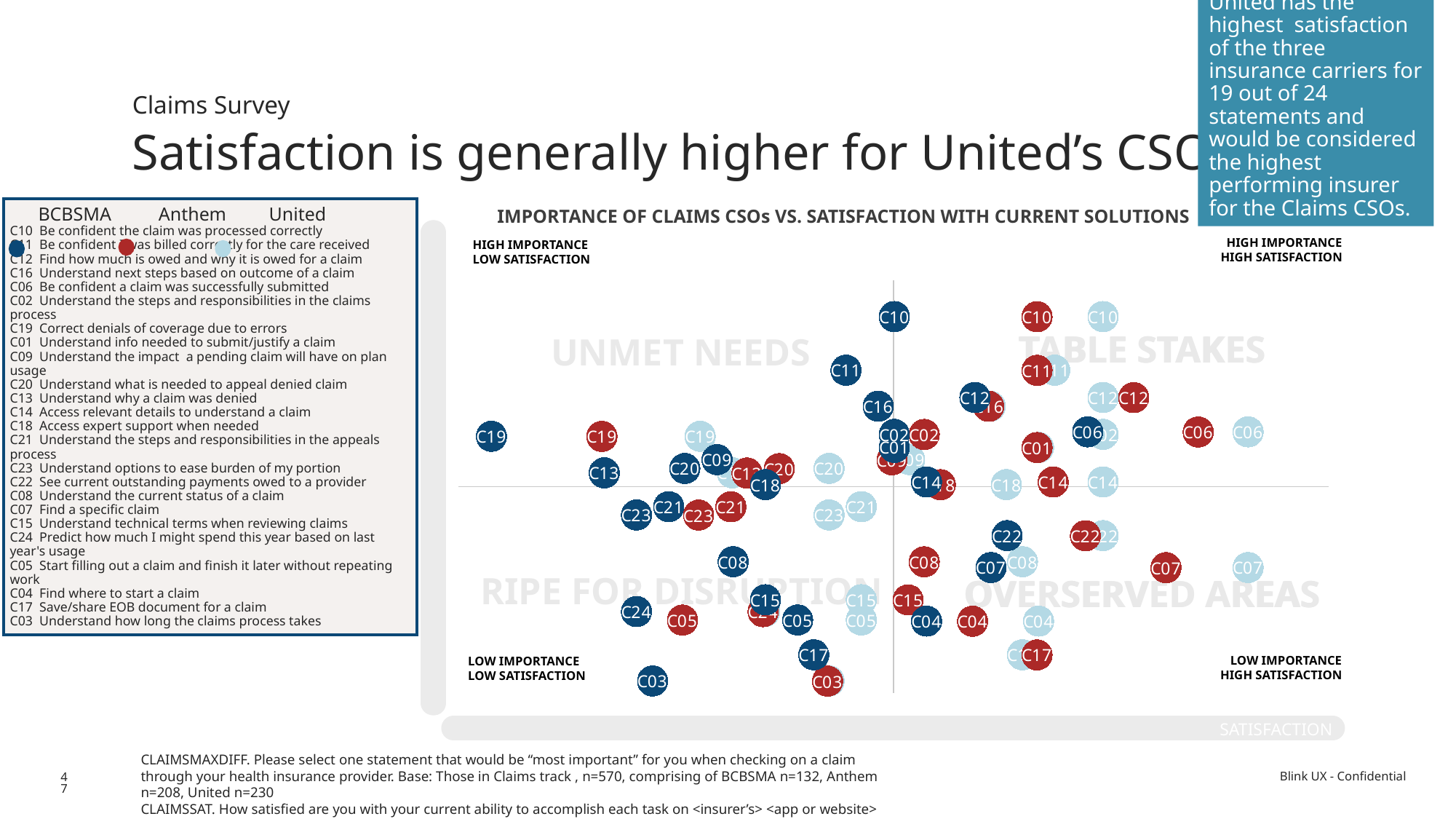
How many claims statements (C-codes) are listed in the chart's key? 24 Which statement code is plotted with the highest importance across all three insurers? C10 What kind of chart is shown on the slide? Scatter chart Which quadrant label appears in the upper-right (high importance, high satisfaction) area of the chart? TABLE STAKES How many insurers (series) does the chart's legend list? 3 For statement C19, which insurer has the lowest satisfaction? BCBSMA Which statement code is plotted with the lowest importance in the chart? C03 For statement C10, which insurer has the highest satisfaction? United For statement C13, is satisfaction higher for BCBSMA or Anthem? Anthem What is the title of the chart? IMPORTANCE OF CLAIMS CSOs VS. SATISFACTION WITH CURRENT SOLUTIONS Which three insurers are plotted in the chart? BCBSMA, Anthem, United